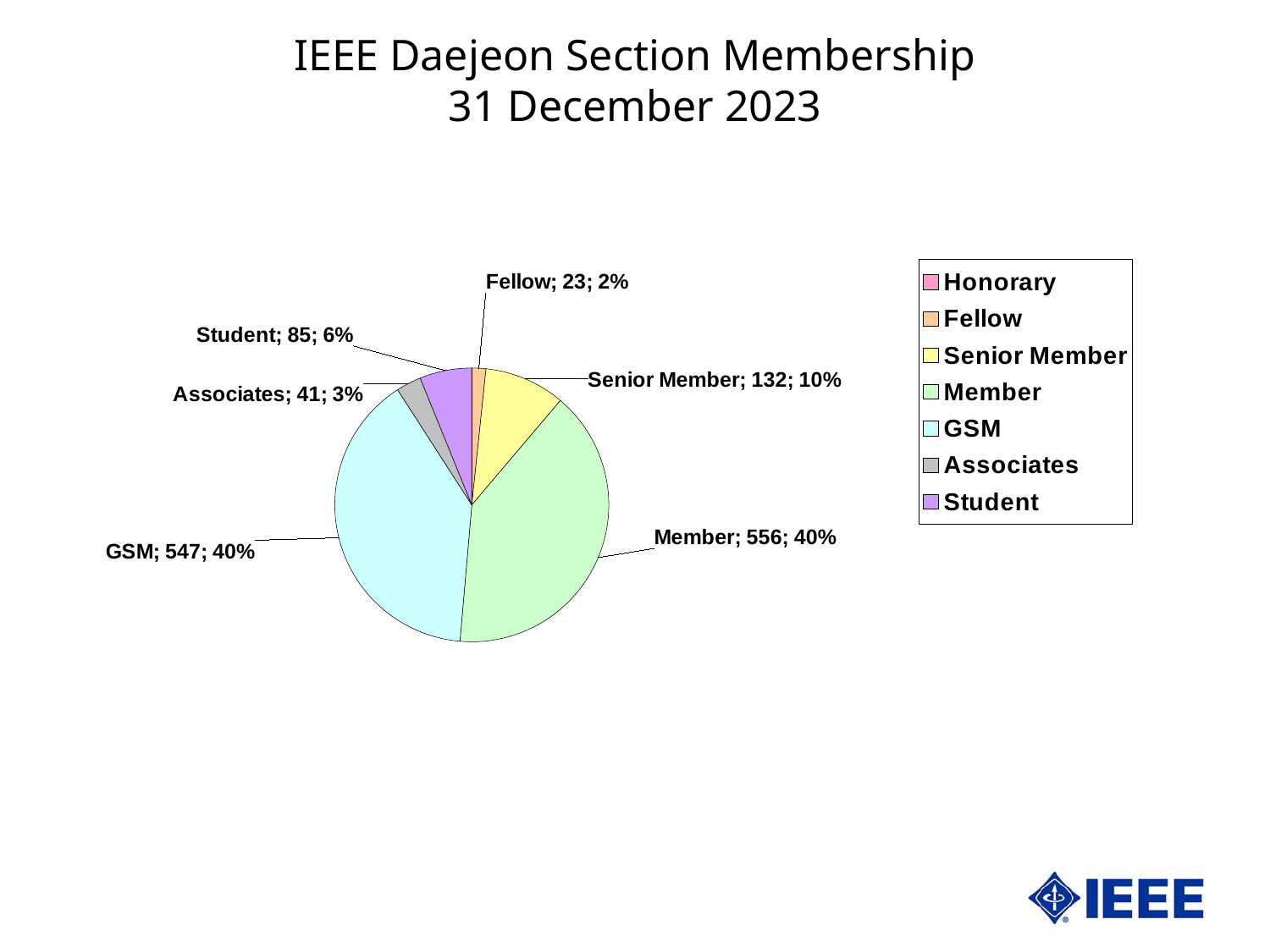
What type of chart is shown on the slide? pie chart How many members are in the Member category? 556 How many categories are listed in the legend? 7 What is the title of the chart? IEEE Daejeon Section Membership 31 December 2023 Which is larger, the Senior Member count or the Student count? Senior Member Which category has the largest value in the chart? Member What is the difference between the Member count and the GSM count? 9 How many Fellows are shown in the chart? 23 What percentage of the membership is Senior Member? 10% Which labeled category has the smallest value in the chart? Fellow What share of the pie does the Student category represent? 6% How many members are in the GSM category? 547